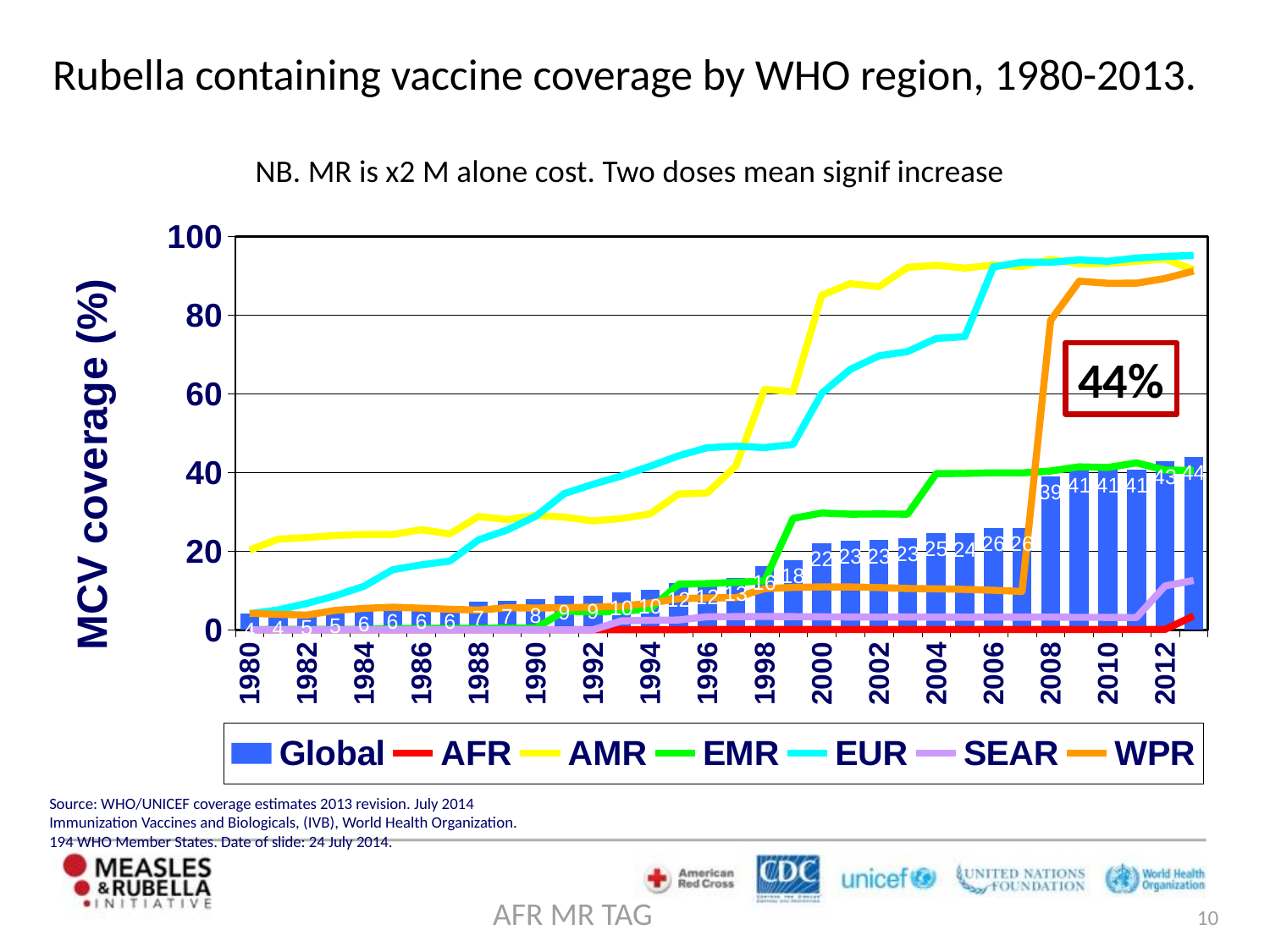
What is the difference between the Global values for 2013 and 2008? 5 What is the Global value for 2000? 22 Is the WPR value for 2008 greater or less than 60? greater In which year is the Global bar highest? 2013 Do the Global bars generally rise or fall from 1980 to 2013? rise Is the AMR value for 2012 greater or less than 80? greater What is the title of the vertical axis? MCV coverage (%) Which is larger in 2000, the AMR value or the AFR value? AMR Is the AFR value for 2012 greater or less than 20? less How many series does the legend list? 7 What is the Global value for 2013? 44 What is the Global value for 2008? 39